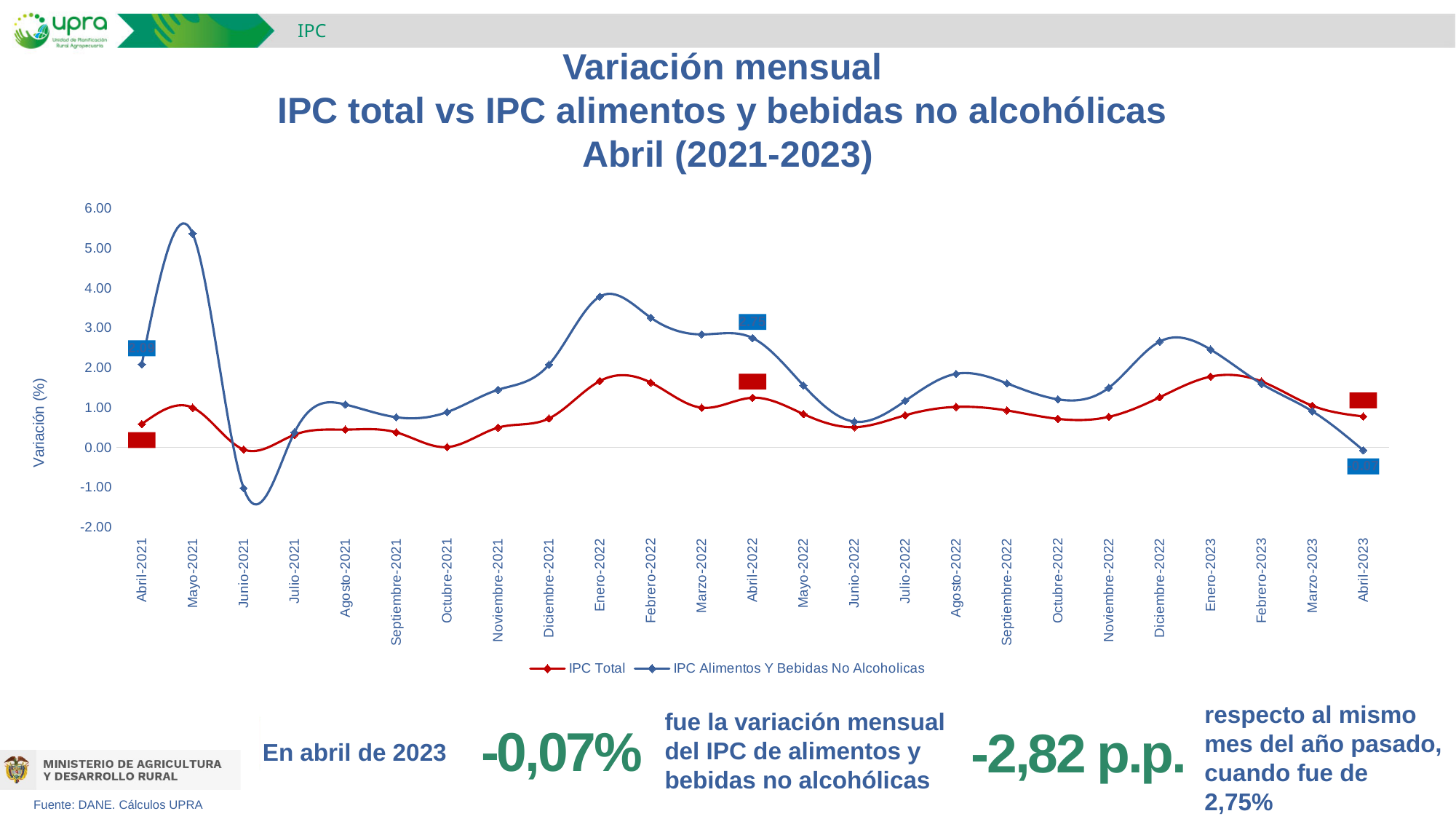
In which month does the IPC Alimentos Y Bebidas No Alcoholicas series reach its highest value? Mayo-2021 What kind of chart is shown on the slide? line chart Does the IPC Alimentos Y Bebidas No Alcoholicas series rise or fall from Diciembre-2022 to Abril-2023? fall Is the value of IPC Alimentos Y Bebidas No Alcoholicas for Junio-2021 greater or less than 0.00? less Is the value of IPC Alimentos Y Bebidas No Alcoholicas for Enero-2022 greater or less than 3.00? greater In Abril-2023, which series has the larger value, IPC Total or IPC Alimentos Y Bebidas No Alcoholicas? IPC Total Which colour is used for the IPC Total series? red How many months are plotted along the x axis? 25 In which month does the IPC Alimentos Y Bebidas No Alcoholicas series reach its lowest value? Junio-2021 According to the slide, what was the monthly variation of the IPC de alimentos y bebidas no alcohólicas in April 2023? -0,07% Is the value of IPC Alimentos Y Bebidas No Alcoholicas for Mayo-2021 greater or less than 5.00? greater How many series does the legend list? 2